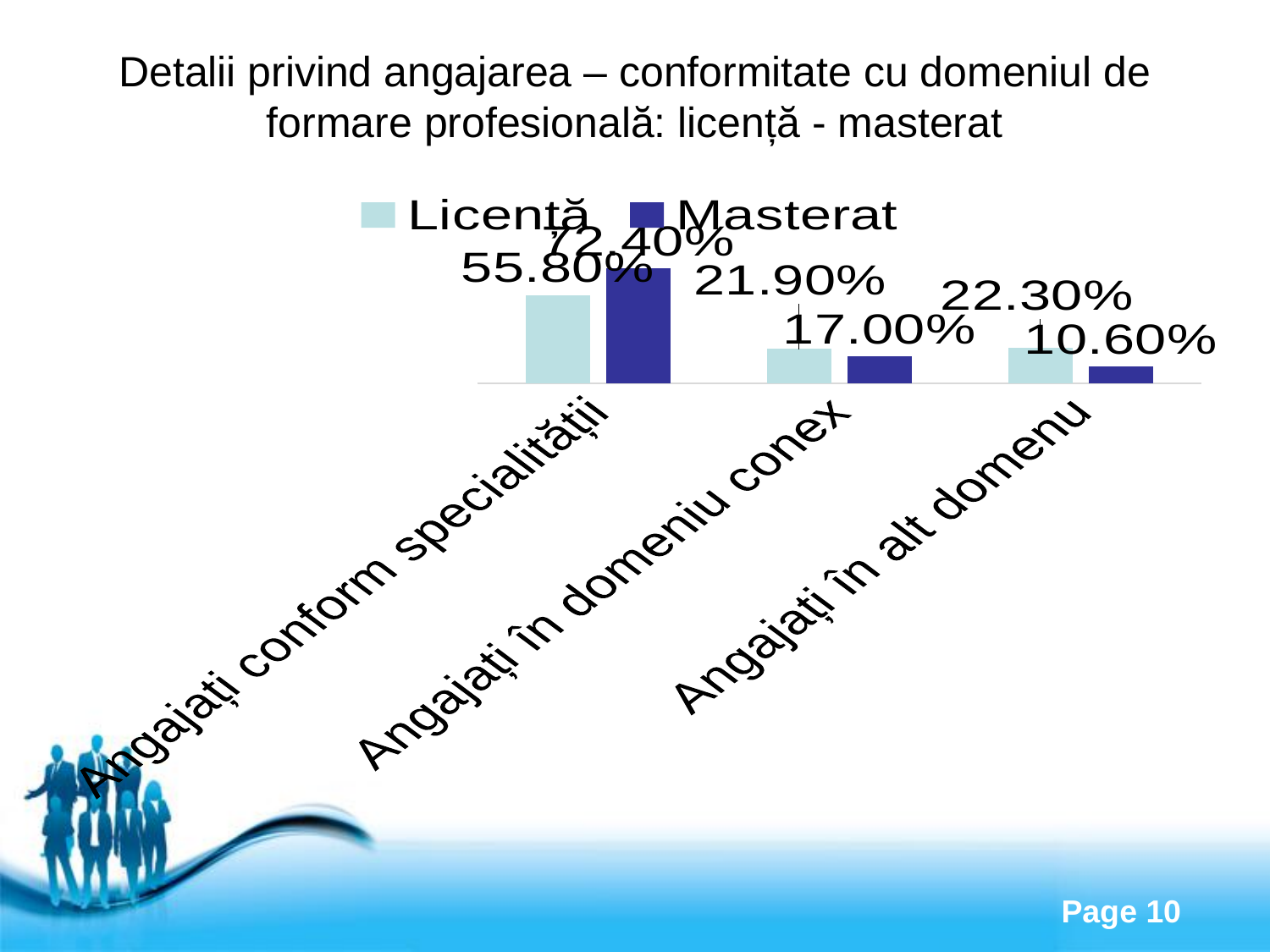
What is the Licență value for Angajați în domeniu conex? 21.90% For Angajați în alt domenu, which series has the larger value, Licență or Masterat? Licență What is the difference between the Masterat and Licență values for Angajați conform specialității? 16.60% How many categories are shown on the x axis? 3 Which category has the lowest Licență value? Angajați în domeniu conex How many series does the legend list? 2 What is the Masterat value for Angajați conform specialității? 72.40% What is the Licență value for Angajați conform specialității? 55.80% What is the Masterat value for Angajați în alt domenu? 10.60% What kind of chart is shown on the slide? bar chart Which category has the highest Masterat value? Angajați conform specialității Which series is shown in dark blue in the legend? Masterat